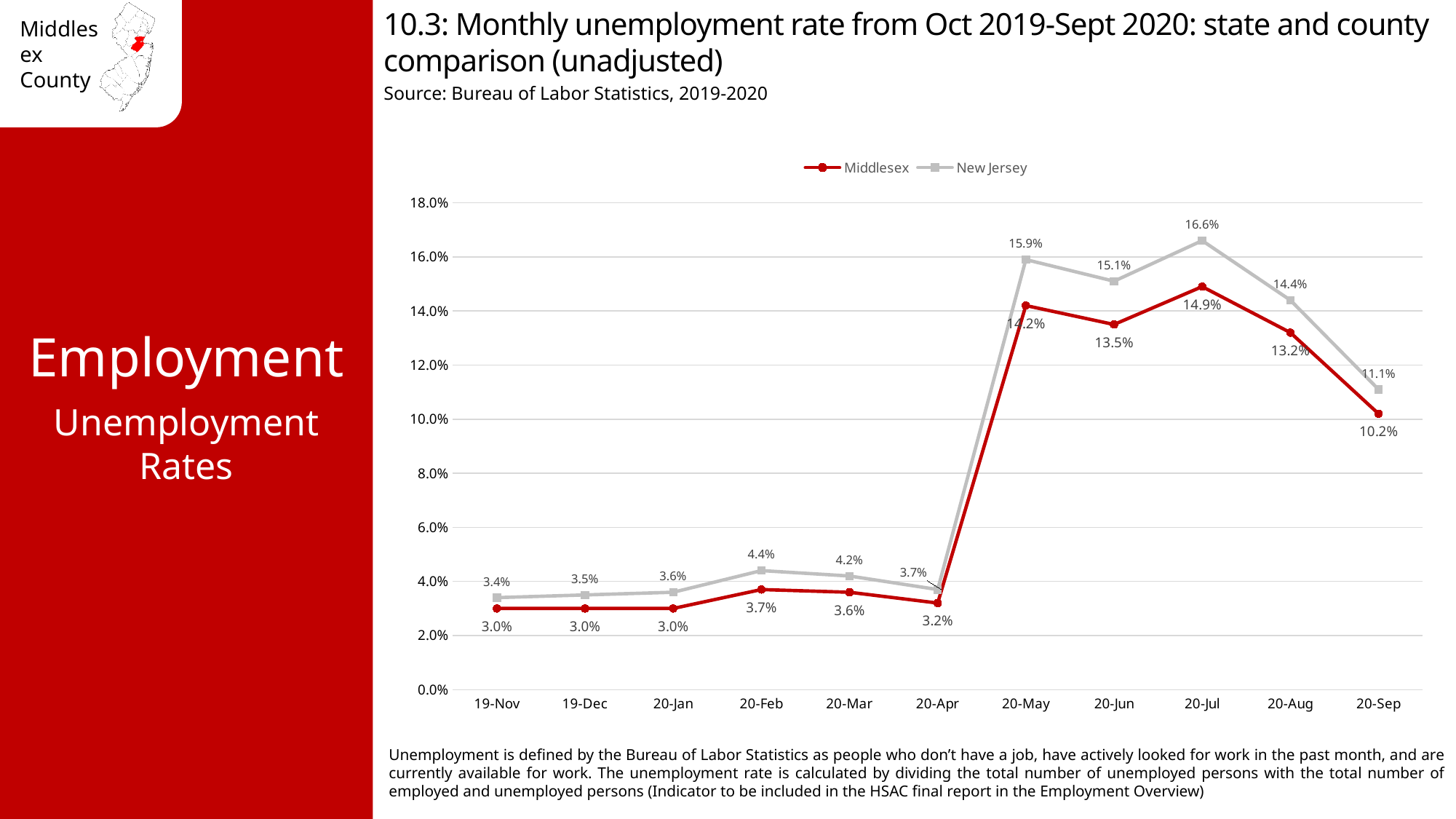
What is the difference between the New Jersey and Middlesex unemployment rates in 20-Jul? 1.7% What was the Middlesex unemployment rate in 20-Jul? 14.9% What type of chart is shown on the slide? Line chart Did the Middlesex unemployment rate rise or fall from 20-Jul to 20-Sep? Fall What was the Middlesex unemployment rate in 20-Sep? 10.2% How many months are plotted on the x axis? 11 How many series does the legend list? 2 What was the New Jersey unemployment rate in 20-May? 15.9% Which colour is used for the Middlesex line? Red What is the lowest Middlesex unemployment rate shown on the chart? 3.0% In which month did the New Jersey unemployment rate reach its highest value? 20-Jul Which series had the higher unemployment rate in 20-Feb, Middlesex or New Jersey? New Jersey